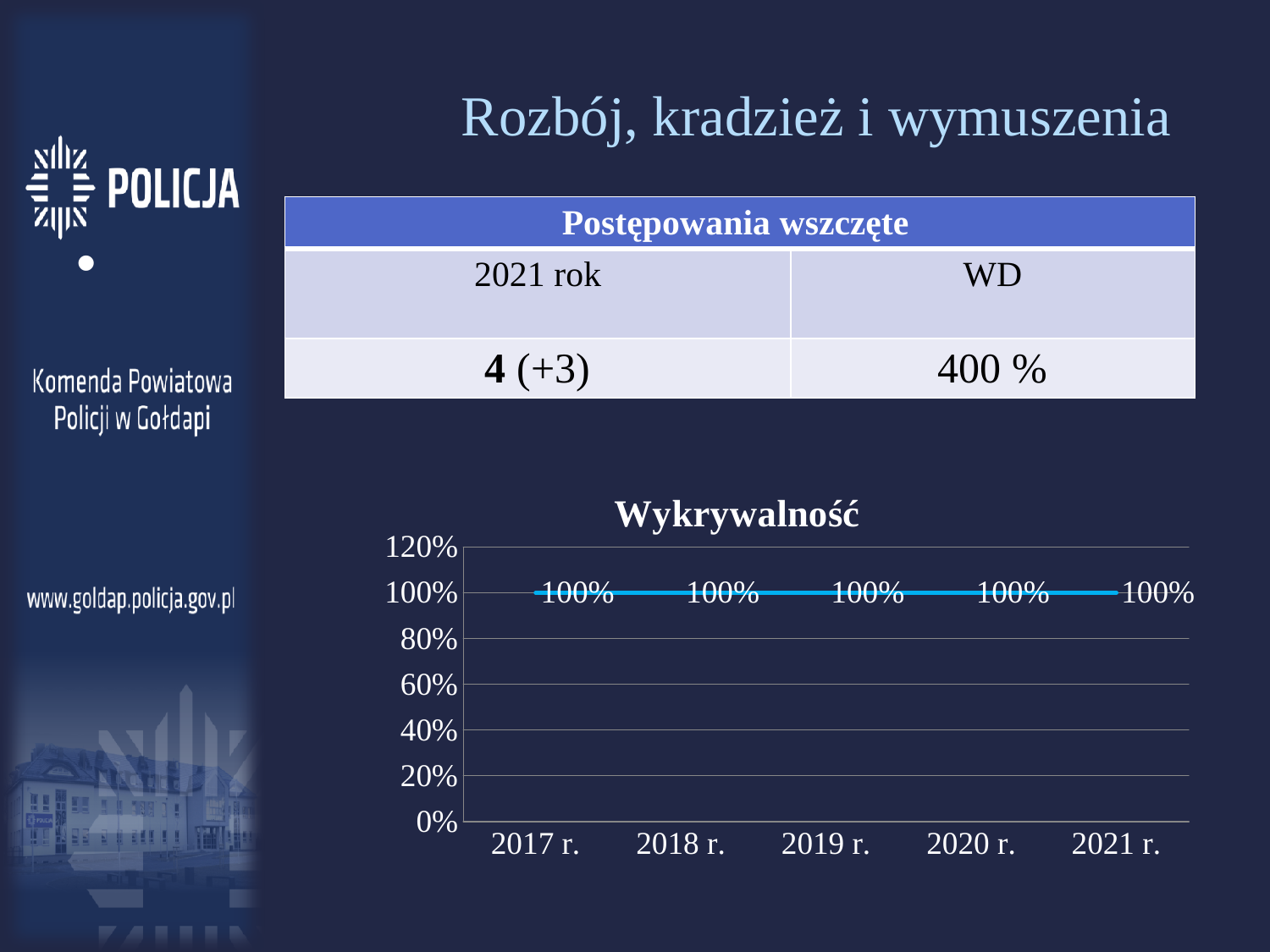
Is the value for 2020 r. in the Wykrywalność chart greater or less than 80%? greater What is the value for 2019 r. in the Wykrywalność chart? 100% What is the title of the chart on the slide? Wykrywalność What is the highest value shown on the y axis of the Wykrywalność chart? 120% Do the values in the Wykrywalność chart rise, fall or stay the same from 2017 r. to 2021 r.? stay the same What is the value for 2021 r. in the Wykrywalność chart? 100% Is the value for 2018 r. in the Wykrywalność chart greater or less than 120%? less How many years are plotted on the x axis of the Wykrywalność chart? 5 What is the difference between the values for 2018 r. and 2020 r. in the Wykrywalność chart? 0% What is the value for 2017 r. in the Wykrywalność chart? 100% What kind of chart is the Wykrywalność chart? line chart